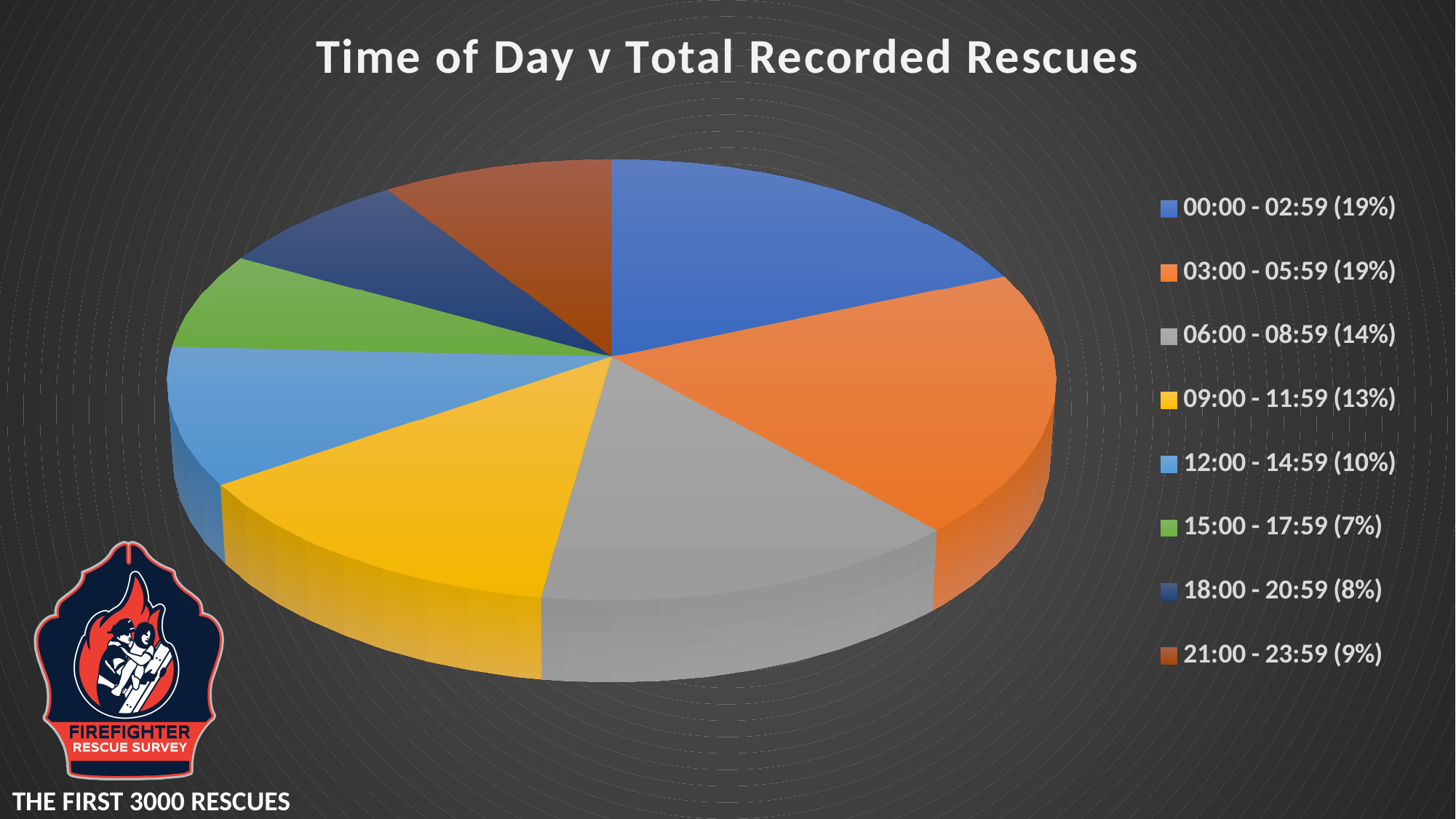
What percentage is shown for the 03:00 - 05:59 time period? 19% What colour is the slice for 09:00 - 11:59? yellow What percentage is shown for the 21:00 - 23:59 time period? 9% What share of total recorded rescues occurred between 06:00 and 08:59? 14% What is the difference in percentage points between the 00:00 - 02:59 and 09:00 - 11:59 periods? 6 What is the combined share of the 00:00 - 02:59 and 03:00 - 05:59 periods? 38% Which has a larger share of rescues, 18:00 - 20:59 or 21:00 - 23:59? 21:00 - 23:59 What percentage is shown for the 12:00 - 14:59 time period? 10% Which time period has the smallest share of recorded rescues? 15:00 - 17:59 What type of chart is shown on the slide? pie chart What is the title of the chart? Time of Day v Total Recorded Rescues How many time-of-day categories does the pie chart have? 8